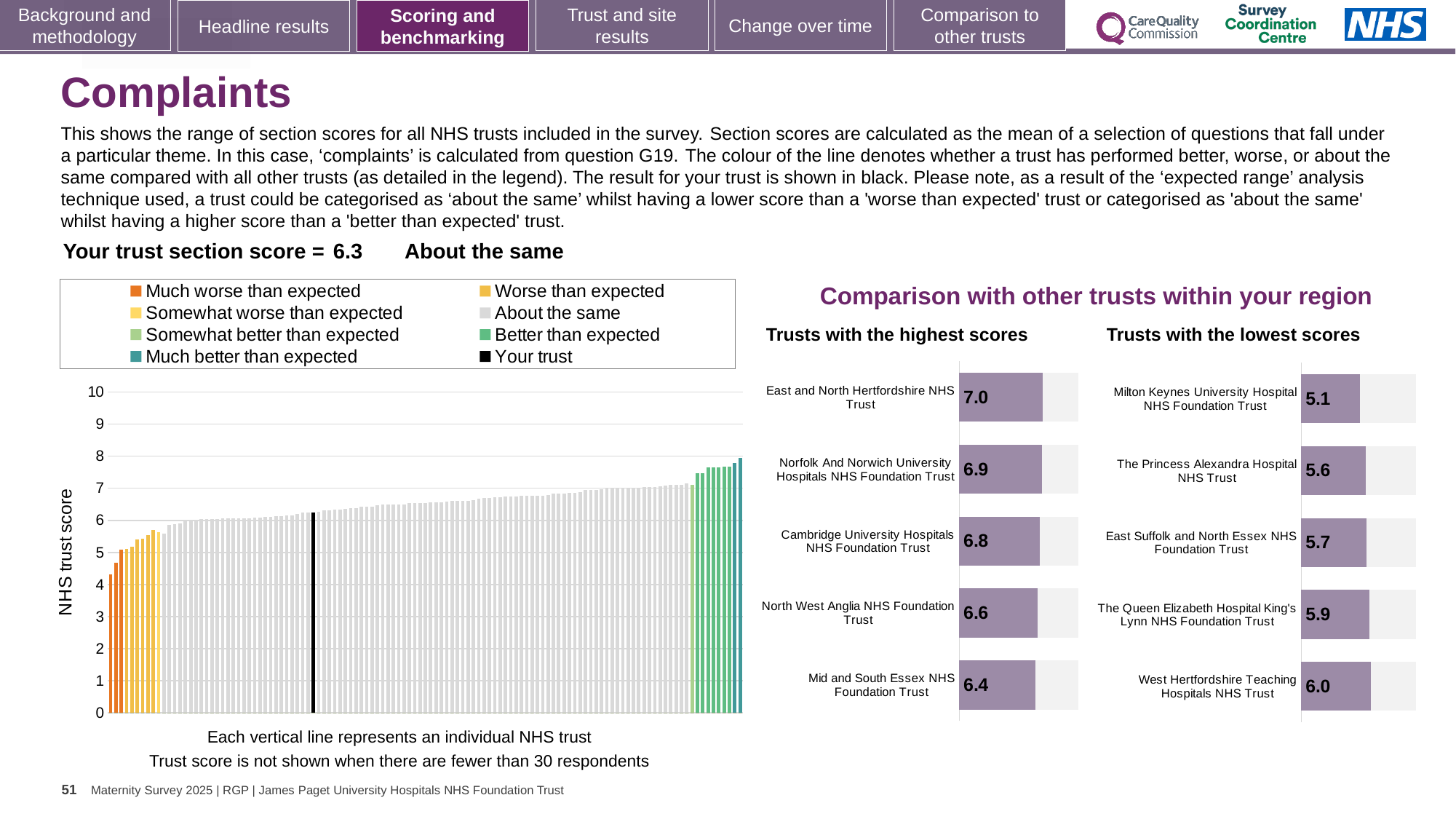
In the 'Trusts with the highest scores' chart, which trust has the lowest score? Mid and South Essex NHS Foundation Trust In the NHS trust score chart on the left, is the value for the black bar (your trust) greater or less than 6? greater In the NHS trust score chart on the left, is the value of the tallest bar greater or less than 8? less In the 'Trusts with the highest scores' chart, what is the difference between the scores of East and North Hertfordshire NHS Trust and Mid and South Essex NHS Foundation Trust? 0.6 In the 'Trusts with the lowest scores' chart, what is the score for Milton Keynes University Hospital NHS Foundation Trust? 5.1 How many entries does the legend of the NHS trust score chart on the left list? 8 In the 'Trusts with the lowest scores' chart, which has the larger score: The Princess Alexandra Hospital NHS Trust or The Queen Elizabeth Hospital King's Lynn NHS Foundation Trust? The Queen Elizabeth Hospital King's Lynn NHS Foundation Trust In the 'Trusts with the highest scores' chart, what is the score for Cambridge University Hospitals NHS Foundation Trust? 6.8 In the 'Trusts with the lowest scores' chart, which trust has the highest score? West Hertfordshire Teaching Hospitals NHS Trust In the 'Trusts with the highest scores' chart, what is the score for East and North Hertfordshire NHS Trust? 7.0 In the 'Trusts with the lowest scores' chart, what is the difference between the scores of West Hertfordshire Teaching Hospitals NHS Trust and Milton Keynes University Hospital NHS Foundation Trust? 0.9 How many trusts are listed in the 'Trusts with the lowest scores' chart? 5